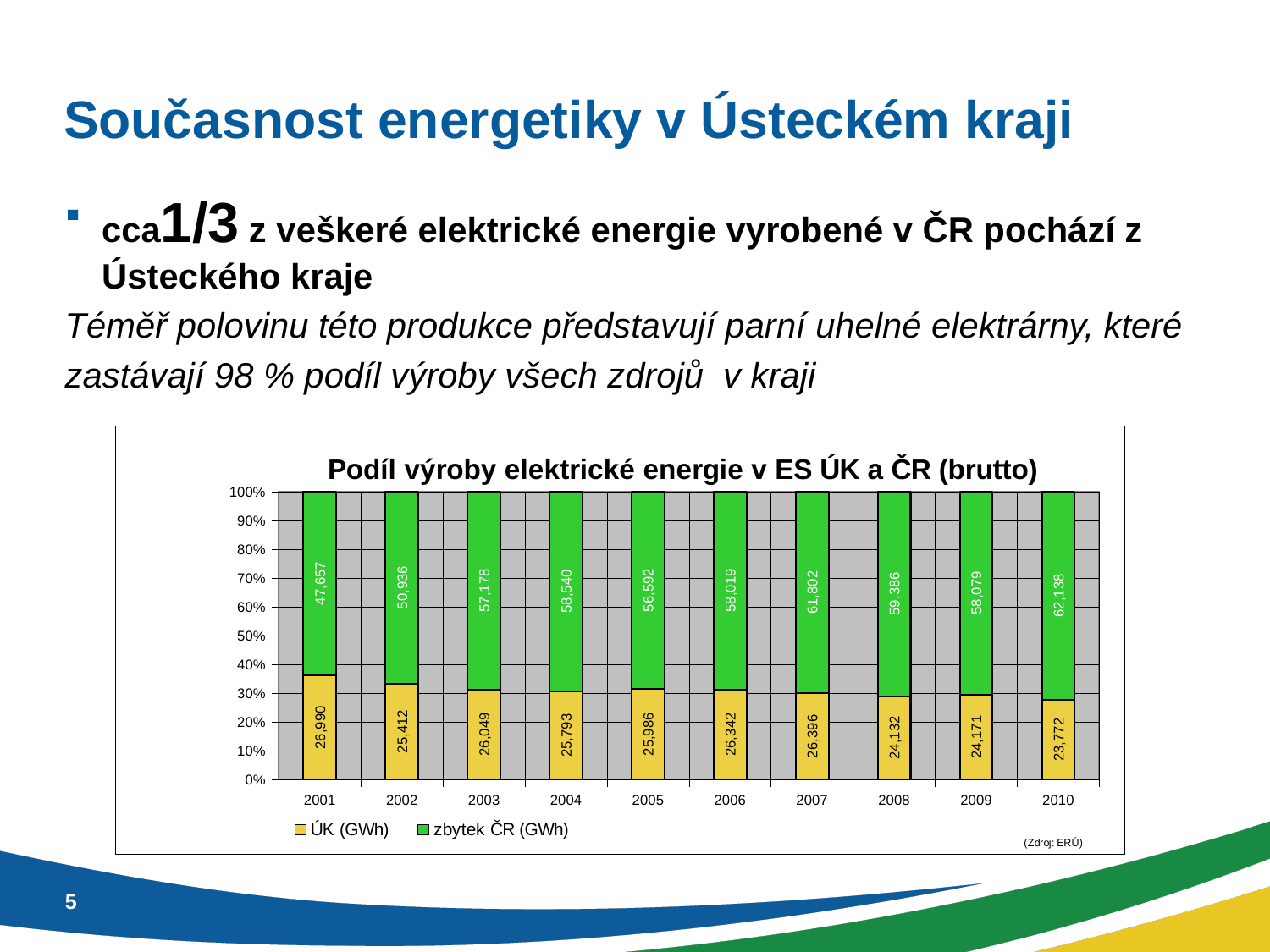
What is the total of ÚK (GWh) and zbytek ČR (GWh) in 2001? 74,647 What is the value for zbytek ČR (GWh) in 2010? 62,138 In which year is the ÚK (GWh) value the lowest? 2010 Which is larger: the ÚK (GWh) value in 2006 or in 2007? 2007 What is the value for ÚK (GWh) in 2001? 26,990 How many years are shown on the x axis? 10 In which year is the zbytek ČR (GWh) value the lowest? 2001 How many series does the legend list? 2 In which year is the ÚK (GWh) value the highest? 2001 Is the share of ÚK (GWh) in 2001 greater or less than 30%? greater What is the value for ÚK (GWh) in 2008? 24,132 What is the difference between zbytek ČR (GWh) and ÚK (GWh) in 2010? 38,366